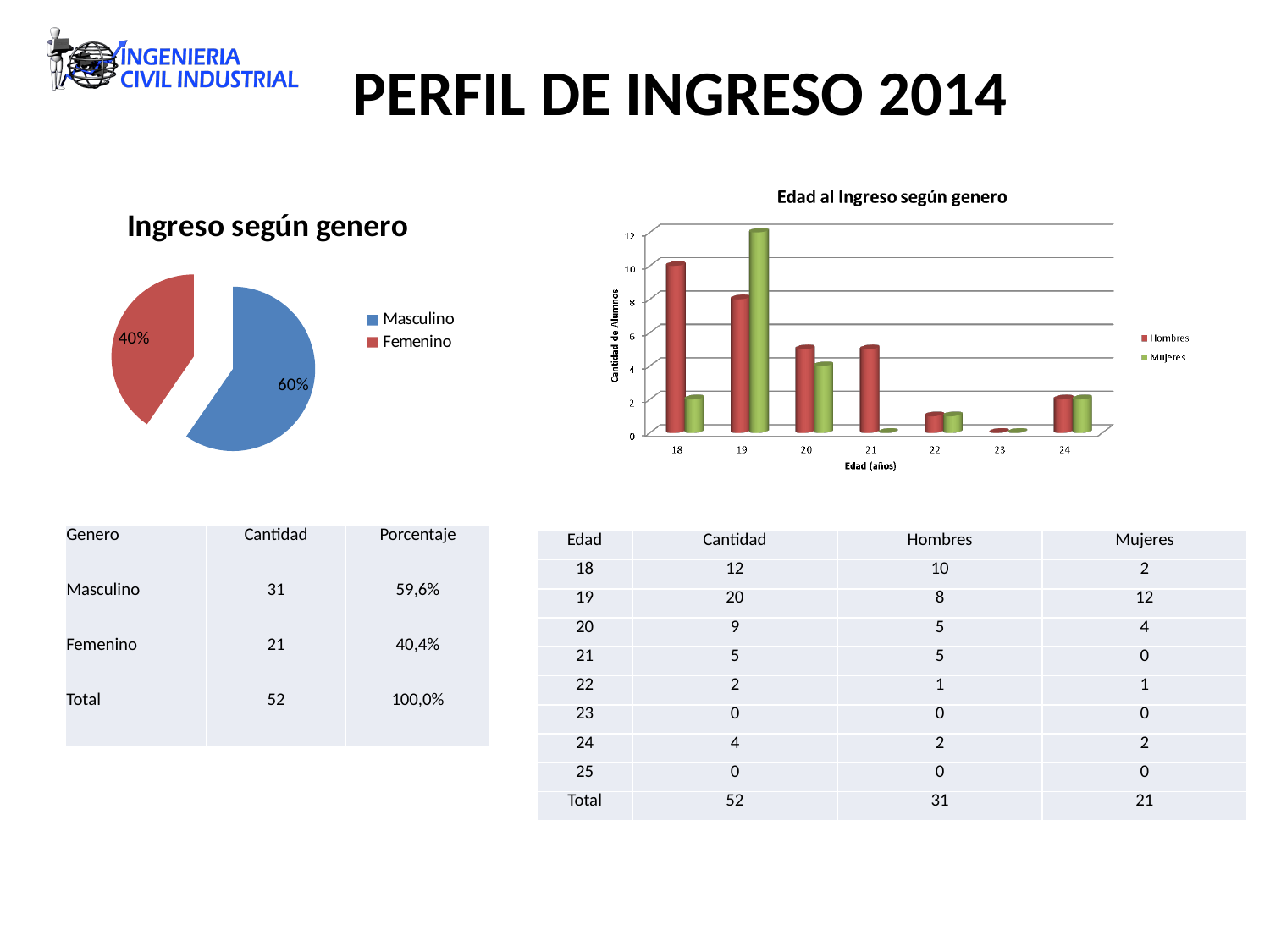
On the pie chart 'Ingreso según genero', how many entries does the legend list? 2 On the chart 'Edad al Ingreso según genero', at which age is the Hombres bar highest? 18 On the chart 'Edad al Ingreso según genero', what is the value for Hombres at age 18? 10 On the pie chart 'Ingreso según genero', what share does Femenino have? 40% On the chart 'Edad al Ingreso según genero', at which age is the Mujeres bar highest? 19 On the chart 'Edad al Ingreso según genero', how many age categories are shown on the x axis? 7 On the pie chart 'Ingreso según genero', which slice is larger, Masculino or Femenino? Masculino On the chart 'Edad al Ingreso según genero', what is the value for Mujeres at age 19? 12 On the chart 'Edad al Ingreso según genero', is the value for Hombres at age 20 greater or less than 4? greater On the pie chart 'Ingreso según genero', what share does Masculino have? 60% On the chart 'Edad al Ingreso según genero', how many series does the legend list? 2 What kind of chart is 'Edad al Ingreso según genero'? Bar chart